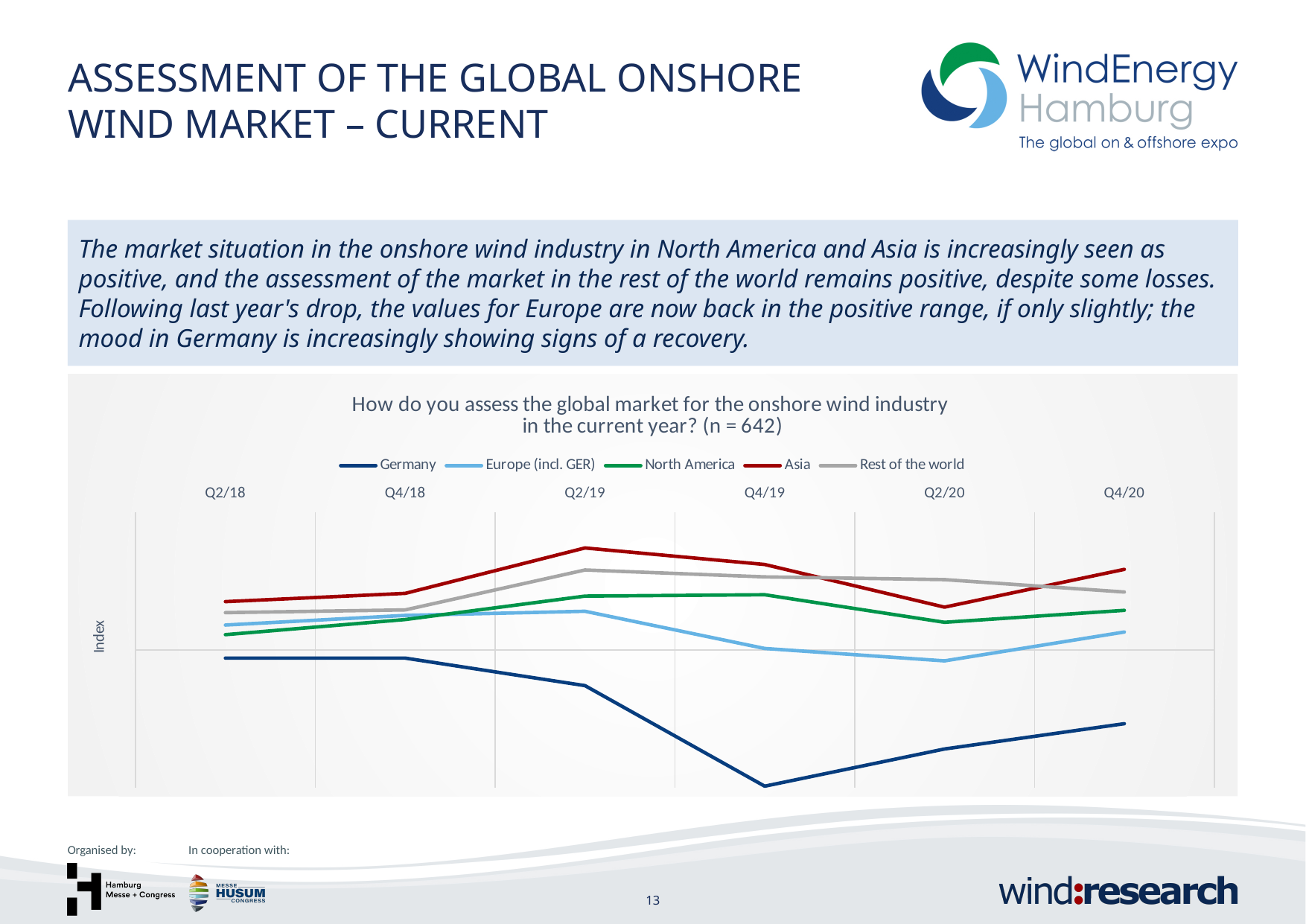
Does the Europe (incl. GER) line rise or fall from Q2/19 to Q2/20? fall What is the sample size (n) given in the chart title? 642 What kind of chart is shown on the slide? line chart How many time points are shown along the x axis of the chart? 6 Which series has the highest value at Q2/19? Asia Does the Germany line rise or fall from Q2/19 to Q4/19? fall Which series has the highest value at Q2/20? Rest of the world Which series has the highest value at Q4/20? Asia At Q4/19, which is higher: Asia or Europe (incl. GER)? Asia Does the Germany line rise or fall from Q4/19 to Q4/20? rise Which series has the lowest value at Q4/19? Germany How many series does the legend of the chart list? 5